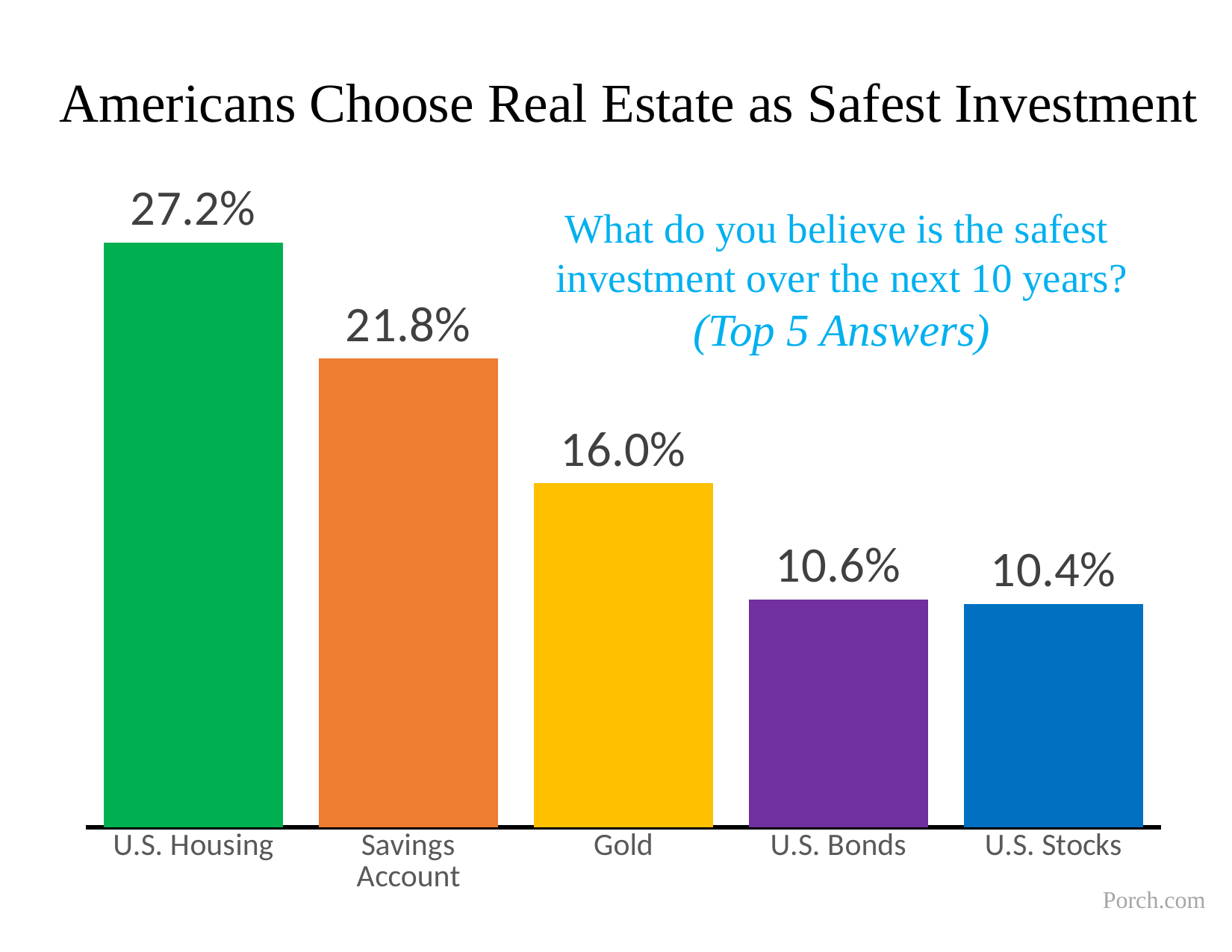
What kind of chart is shown on the slide? Bar chart What is the difference between the values for U.S. Housing and Savings Account? 5.4% What percentage of respondents chose U.S. Housing as the safest investment? 27.2% What is the value shown for Savings Account? 21.8% Which category has the highest value? U.S. Housing What is the difference between the values for Gold and U.S. Bonds? 5.4% What is the title of the slide? Americans Choose Real Estate as Safest Investment Which category has the lowest value? U.S. Stocks What is the value shown for U.S. Stocks? 10.4% Which is larger, the value for Savings Account or the value for Gold? Savings Account What is the value shown for Gold? 16.0% How many categories are shown in the chart? 5